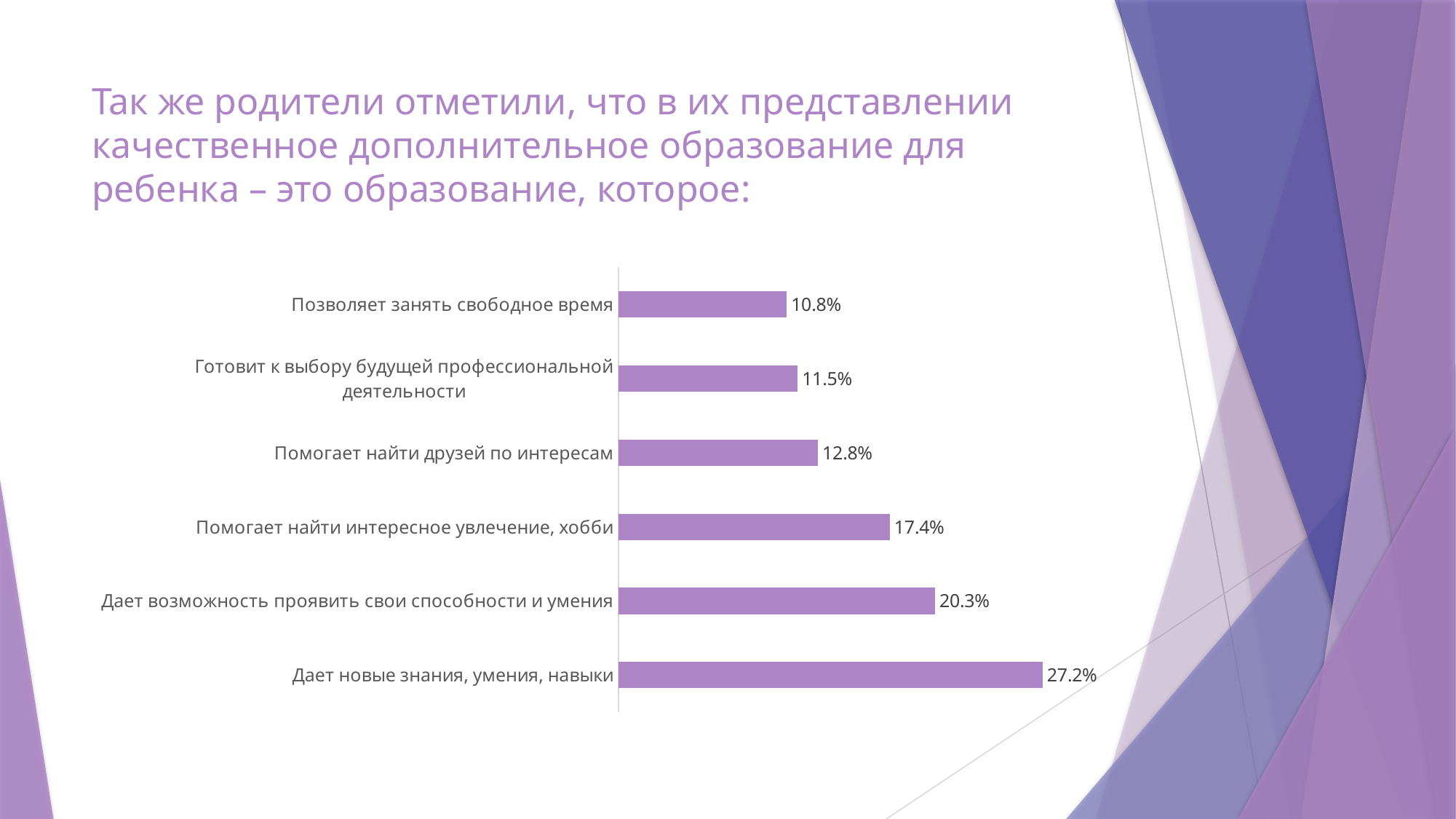
How many categories are shown in the chart? 6 What is the value for "Дает новые знания, умения, навыки"? 27.2% Which category has the highest value? Дает новые знания, умения, навыки What is the difference between the values for "Помогает найти друзей по интересам" and "Позволяет занять свободное время"? 2.0% What is the difference between the values for "Дает новые знания, умения, навыки" and "Дает возможность проявить свои способности и умения"? 6.9% Which is larger: the value for "Помогает найти интересное увлечение, хобби" or for "Помогает найти друзей по интересам"? Помогает найти интересное увлечение, хобби What is the value for "Готовит к выбору будущей профессиональной деятельности"? 11.5% What colour are the bars in the chart? Purple Which category has the lowest value? Позволяет занять свободное время What kind of chart is shown on the slide? Bar chart What is the value for "Позволяет занять свободное время"? 10.8% What is the value for "Помогает найти интересное увлечение, хобби"? 17.4%